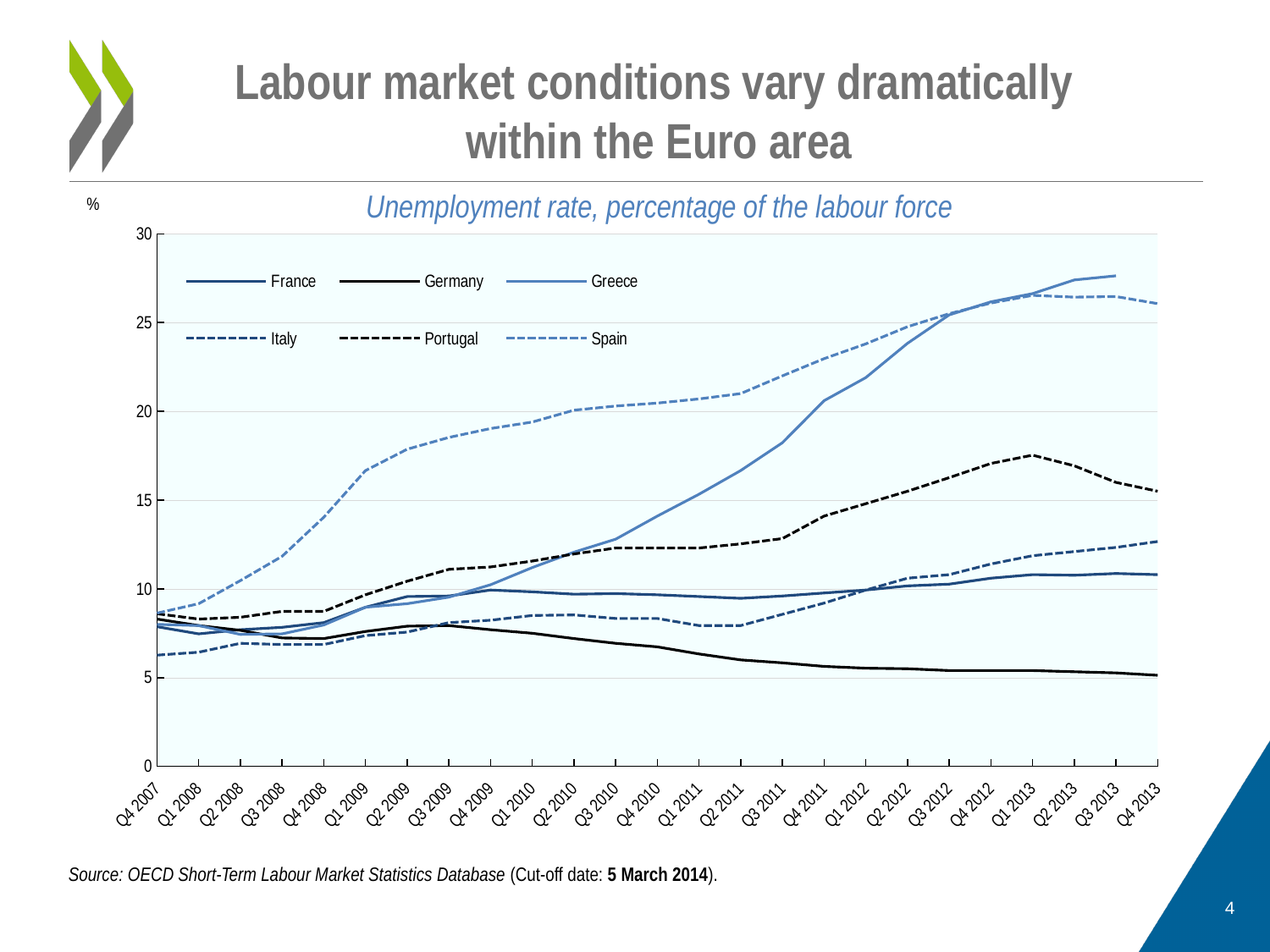
Is the unemployment rate for Greece in Q3 2013 greater or less than 25? greater Which country has the highest unemployment rate in Q1 2009? Spain Is the unemployment rate for Portugal in Q1 2013 greater or less than 15? greater Does the unemployment rate for Germany rise or fall from Q4 2007 to Q4 2013? fall In Q4 2013, which has the higher unemployment rate, Portugal or Italy? Portugal Is the unemployment rate for Germany in Q4 2013 greater or less than 10? less How many series does the legend list? 6 How many quarters are shown along the x axis? 25 Which country has the lowest unemployment rate in Q4 2013? Germany What kind of chart is shown on the slide? Line chart Does the unemployment rate for Greece rise or fall from Q4 2007 to Q3 2013? rise What is the title of the chart? Unemployment rate, percentage of the labour force